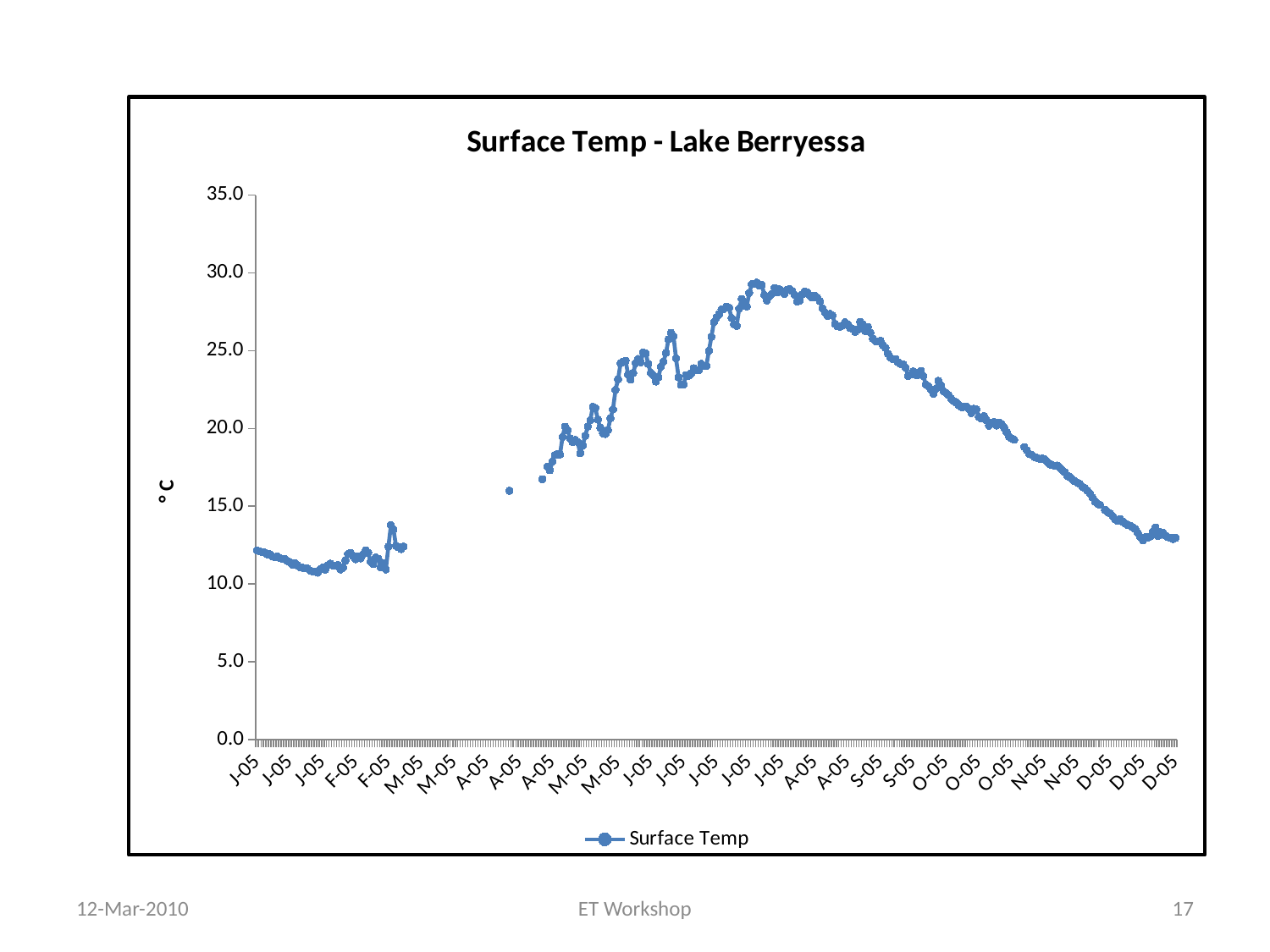
Which is larger: the surface temperature in mid-summer (around the second J-05 / A-05) or in January (first J-05)? mid-summer What is the title of the chart? Surface Temp - Lake Berryessa What kind of chart is shown on the slide? line chart Is the surface temperature at the start of the series in January (first J-05) greater or less than 10.0? greater Is the peak surface temperature reached in summer greater or less than 25.0? greater Is the surface temperature at the start of the series in January (first J-05) greater or less than 15.0? less What is the label on the vertical axis of the chart? °C How many series does the legend list? 1 Does the surface temperature rise or fall from April (A-05) through July (J-05)? rise Does the surface temperature rise or fall from October (O-05) through December (D-05)? fall